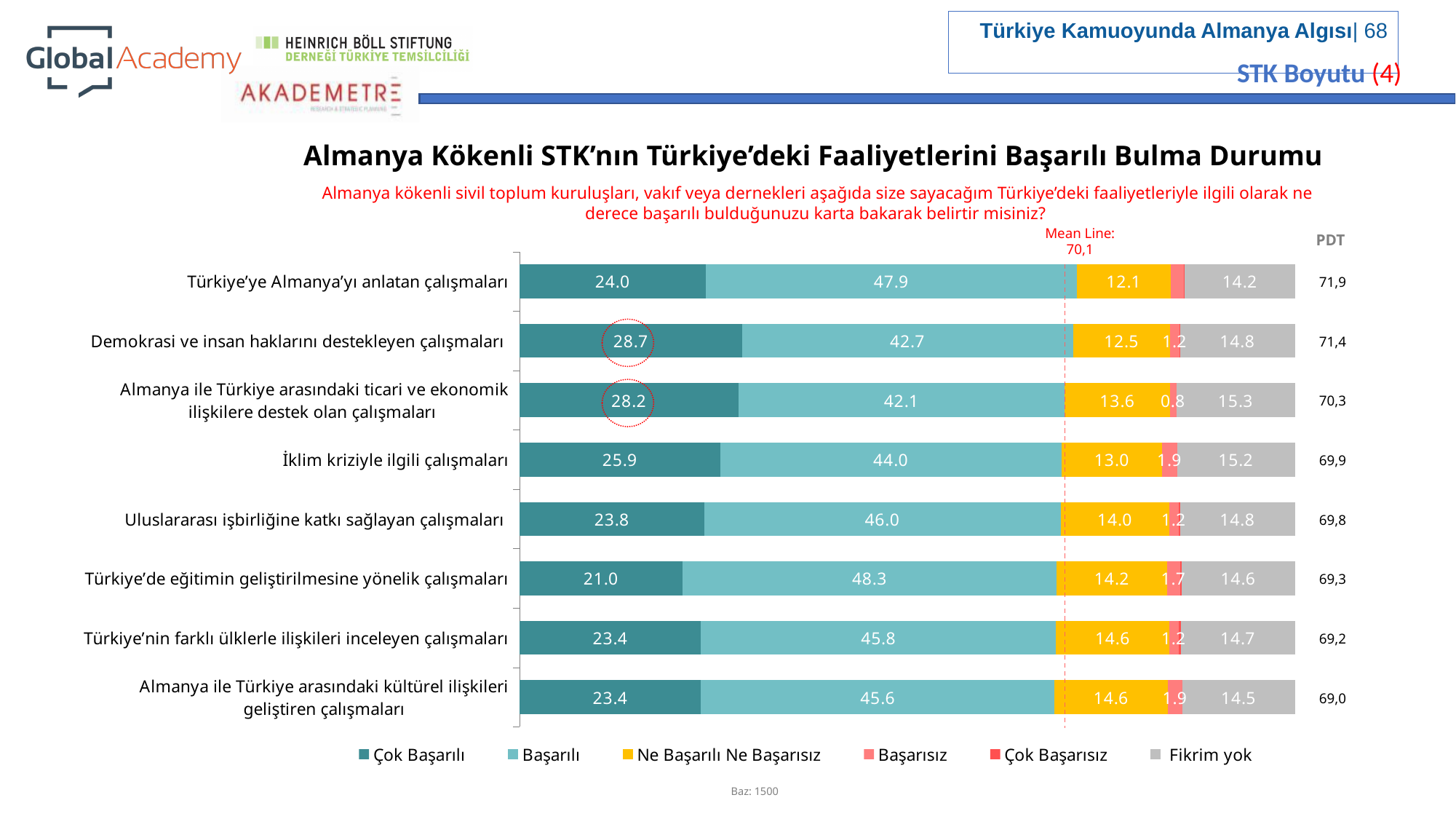
What is the "Çok Başarılı" value for "Türkiye'ye Almanya'yı anlatan çalışmaları"? 24.0 How many series does the legend list? 6 What is the "Fikrim yok" value for "Almanya ile Türkiye arasındaki ticari ve ekonomik ilişkilere destek olan çalışmaları"? 15.3 What is the PDT value shown for "İklim kriziyle ilgili çalışmaları"? 69,9 How many categories (bars) are shown in the chart? 8 What value is given for the Mean Line on the chart? 70,1 Which category has the lowest "Çok Başarılı" value? Türkiye'de eğitimin geliştirilmesine yönelik çalışmaları What is the "Başarılı" value for "Türkiye'de eğitimin geliştirilmesine yönelik çalışmaları"? 48.3 What kind of chart is shown on the slide? Stacked bar chart Which category has the highest "Çok Başarılı" value? Demokrasi ve insan haklarını destekleyen çalışmaları What is the difference between the "Başarılı" values for "Türkiye'ye Almanya'yı anlatan çalışmaları" and "İklim kriziyle ilgili çalışmaları"? 3.9 Which has the larger "Ne Başarılı Ne Başarısız" value: "Uluslararası işbirliğine katkı sağlayan çalışmaları" or "Demokrasi ve insan haklarını destekleyen çalışmaları"? Uluslararası işbirliğine katkı sağlayan çalışmaları